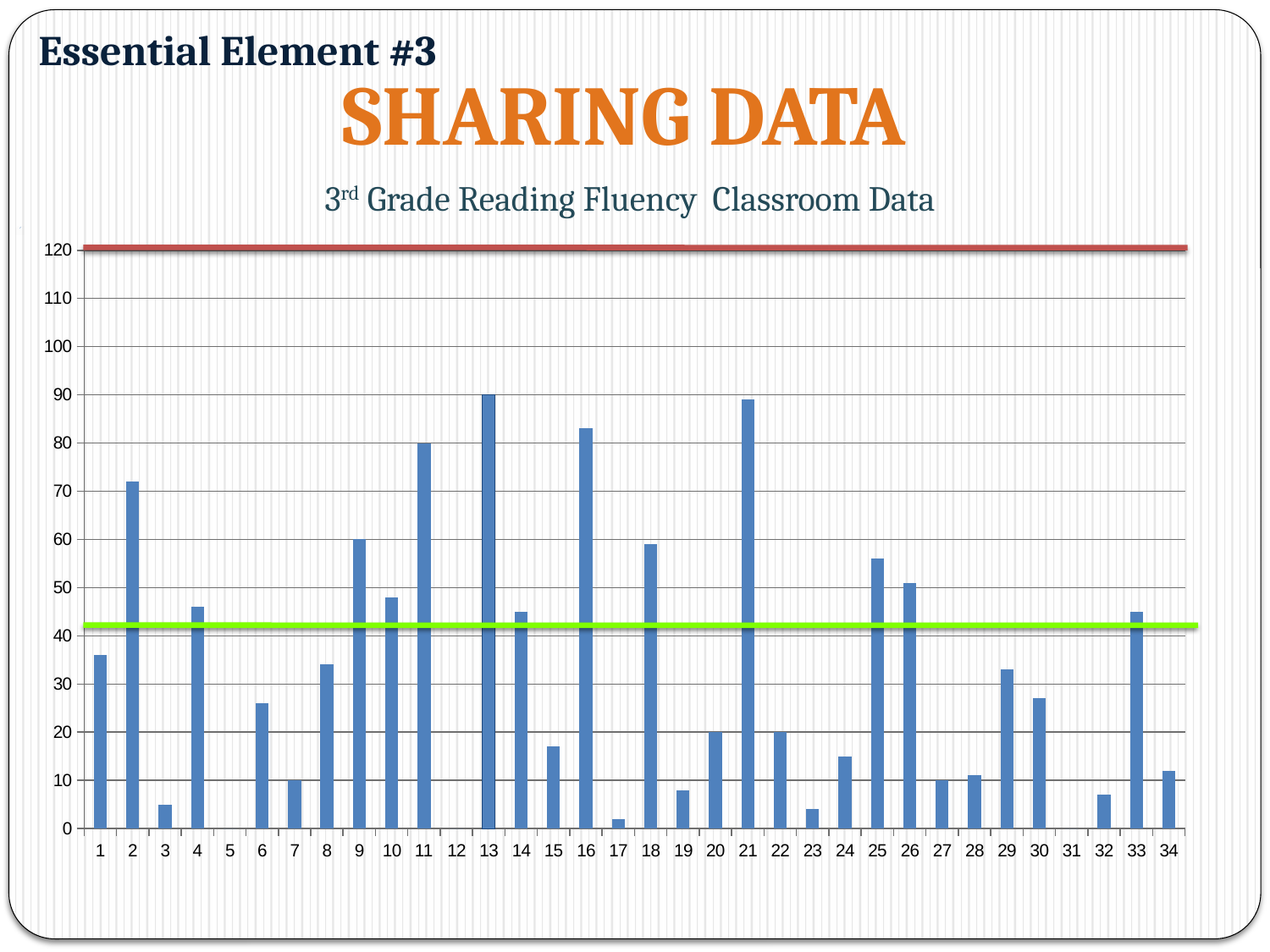
Is the value for category 16 greater or less than 80? greater What kind of chart is shown on the slide? bar chart Is the value for category 18 greater or less than 50? greater What is the title of the chart? 3rd Grade Reading Fluency Classroom Data What is the value for category 11? 80 How many categories are shown along the x axis of the chart? 34 What is the value for category 13? 90 What is the value for category 9? 60 Is the value for category 3 greater or less than 10? less Which is larger, the value for category 26 or the value for category 30? category 26 Which is larger, the value for category 2 or the value for category 4? category 2